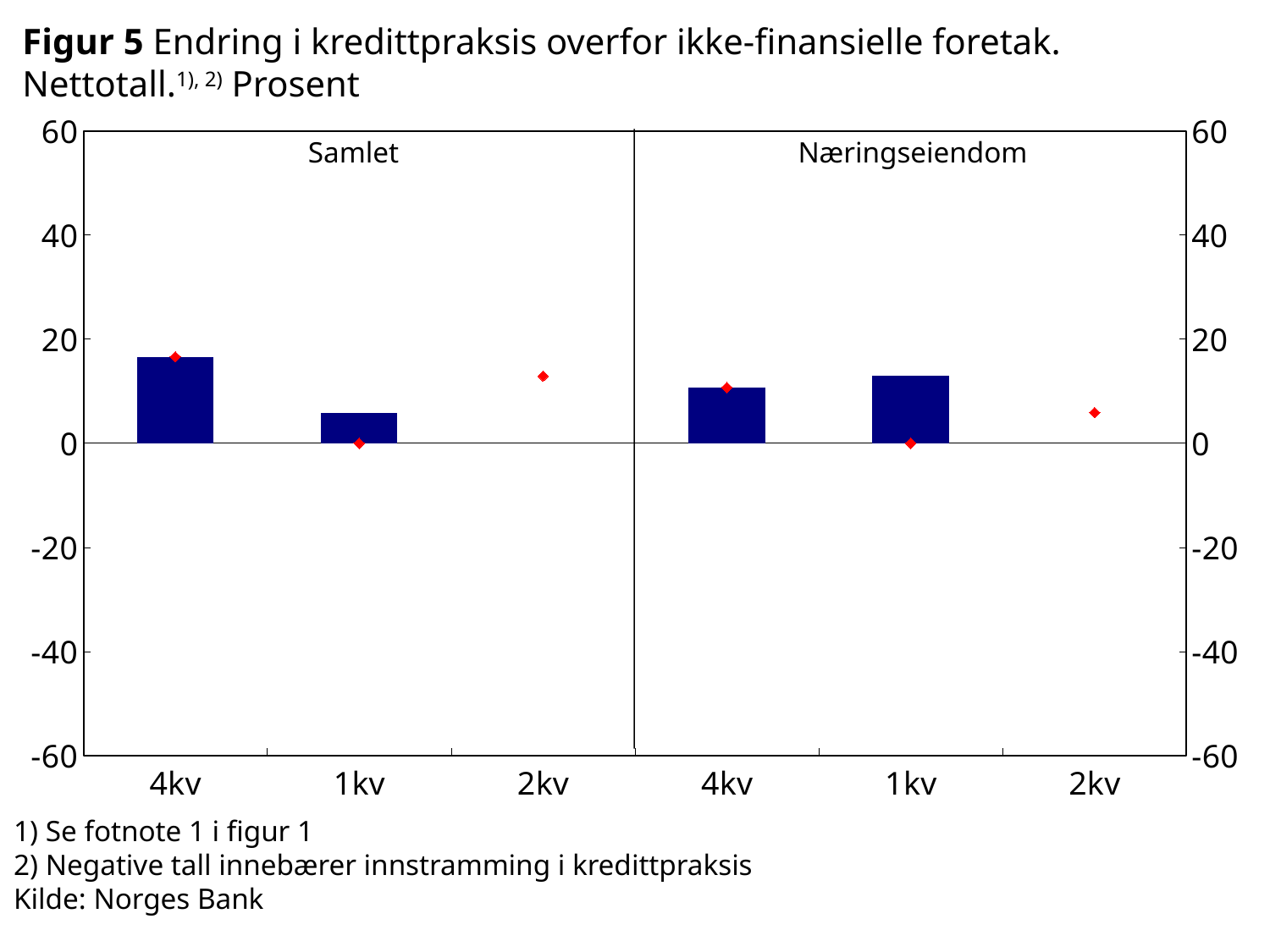
In the Samlet panel, is the bar for 1kv greater or less than 20? less In the Næringseiendom panel, which bar is higher, 4kv or 1kv? 1kv In the Samlet panel, which bar is higher, 4kv or 1kv? 4kv In the Næringseiendom panel, is the bar for 4kv greater or less than 0? greater In the Samlet panel, is the bar for 4kv greater or less than 0? greater What is the figure number of the chart? Figur 5 What kind of chart is shown on the slide? bar chart What are the names of the two panels in the chart? Samlet and Næringseiendom How many quarters are labelled on the x axis of the Samlet panel? 3 In the Samlet panel, do the bars rise or fall from 4kv to 1kv? fall